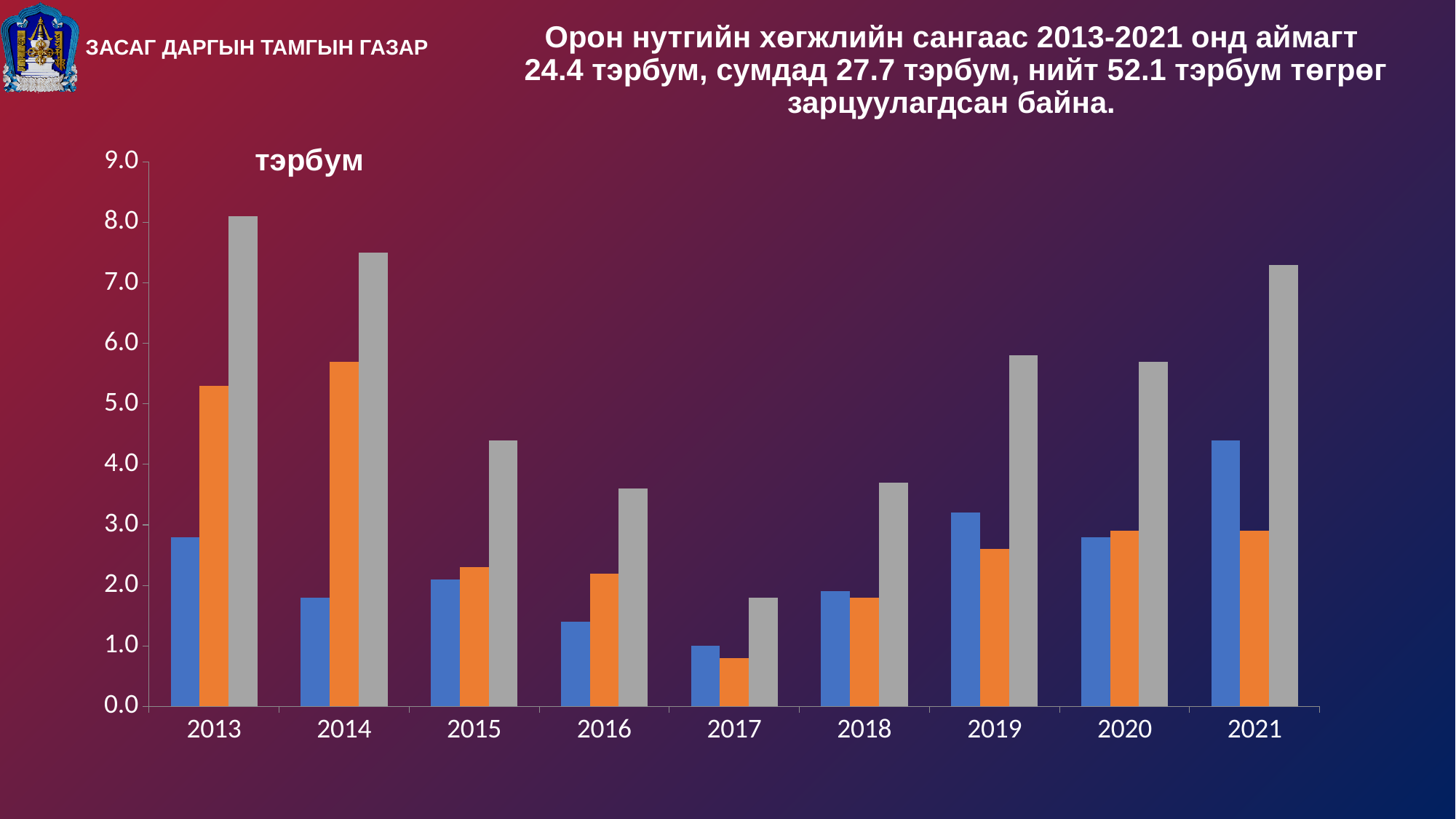
What unit label is printed at the top of the y axis of the chart? тэрбум In which year is the blue bar the tallest? 2021 How many years are shown on the x axis of the chart? 9 Is the orange bar for 2017 greater or less than 1.0? less What kind of chart is shown on the slide? bar chart Which is taller, the gray bar for 2013 or the gray bar for 2014? 2013 In which year is the gray bar the shortest? 2017 In which year is the gray bar the tallest? 2013 Is the gray bar for 2013 greater or less than 7.0? greater Is the blue bar for 2021 greater or less than 4.0? greater In which year is the orange bar the tallest? 2014 How many bars are plotted for each year in the chart? 3